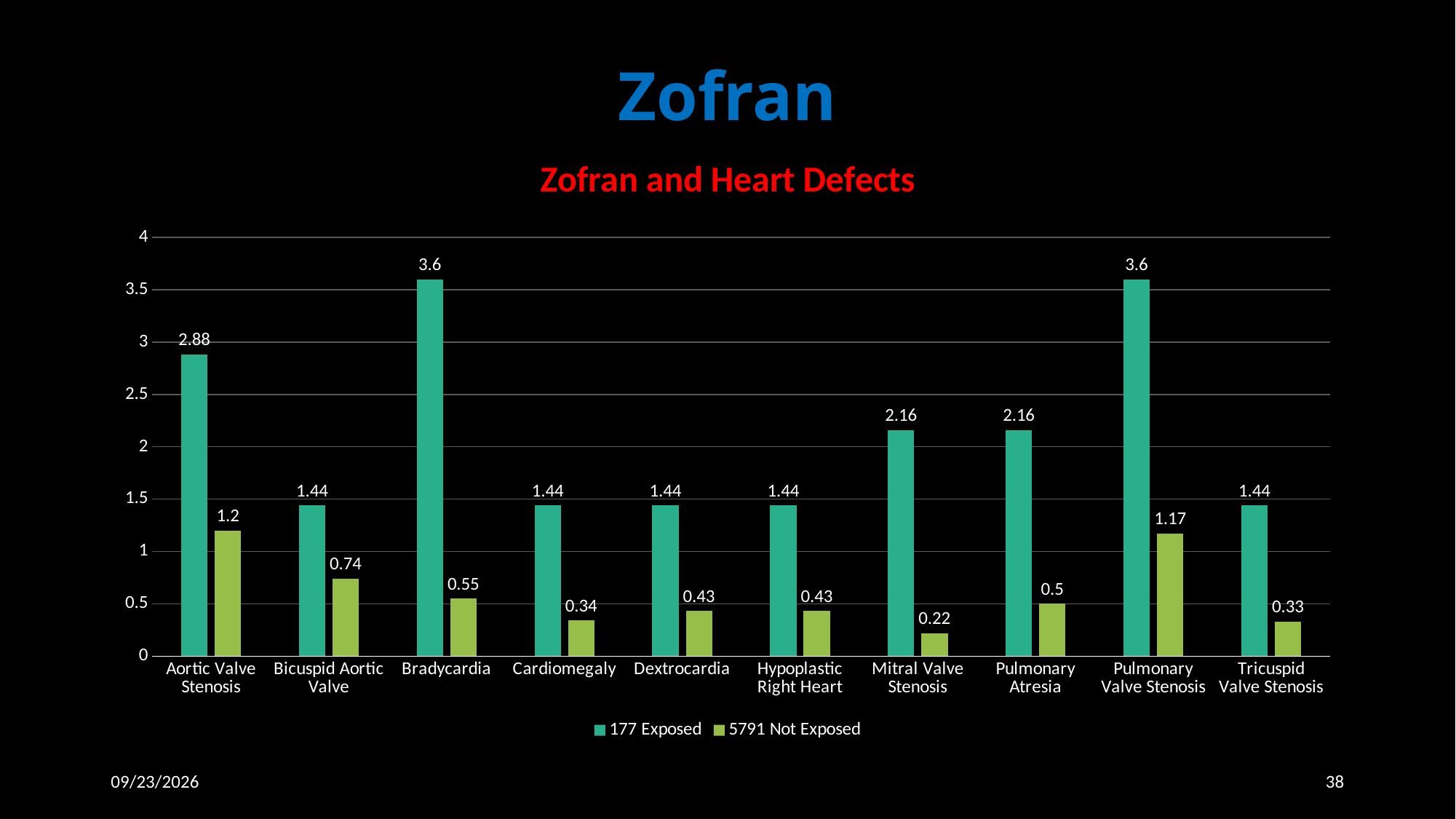
How many series does the legend list? 2 How many categories are shown on the x axis? 10 Which category has the lowest value for 5791 Not Exposed? Mitral Valve Stenosis What is the value for 177 Exposed for Mitral Valve Stenosis? 2.16 What is the difference between the 177 Exposed and 5791 Not Exposed values for Aortic Valve Stenosis? 1.68 What kind of chart is shown on the slide? bar chart What is the value for 5791 Not Exposed for Cardiomegaly? 0.34 Is the value for 177 Exposed for Pulmonary Valve Stenosis greater or less than 3? greater What is the value for 177 Exposed for Bradycardia? 3.6 What is the value for 5791 Not Exposed for Pulmonary Valve Stenosis? 1.17 What is the title of the chart? Zofran and Heart Defects Which is larger for 177 Exposed: Aortic Valve Stenosis or Pulmonary Atresia? Aortic Valve Stenosis